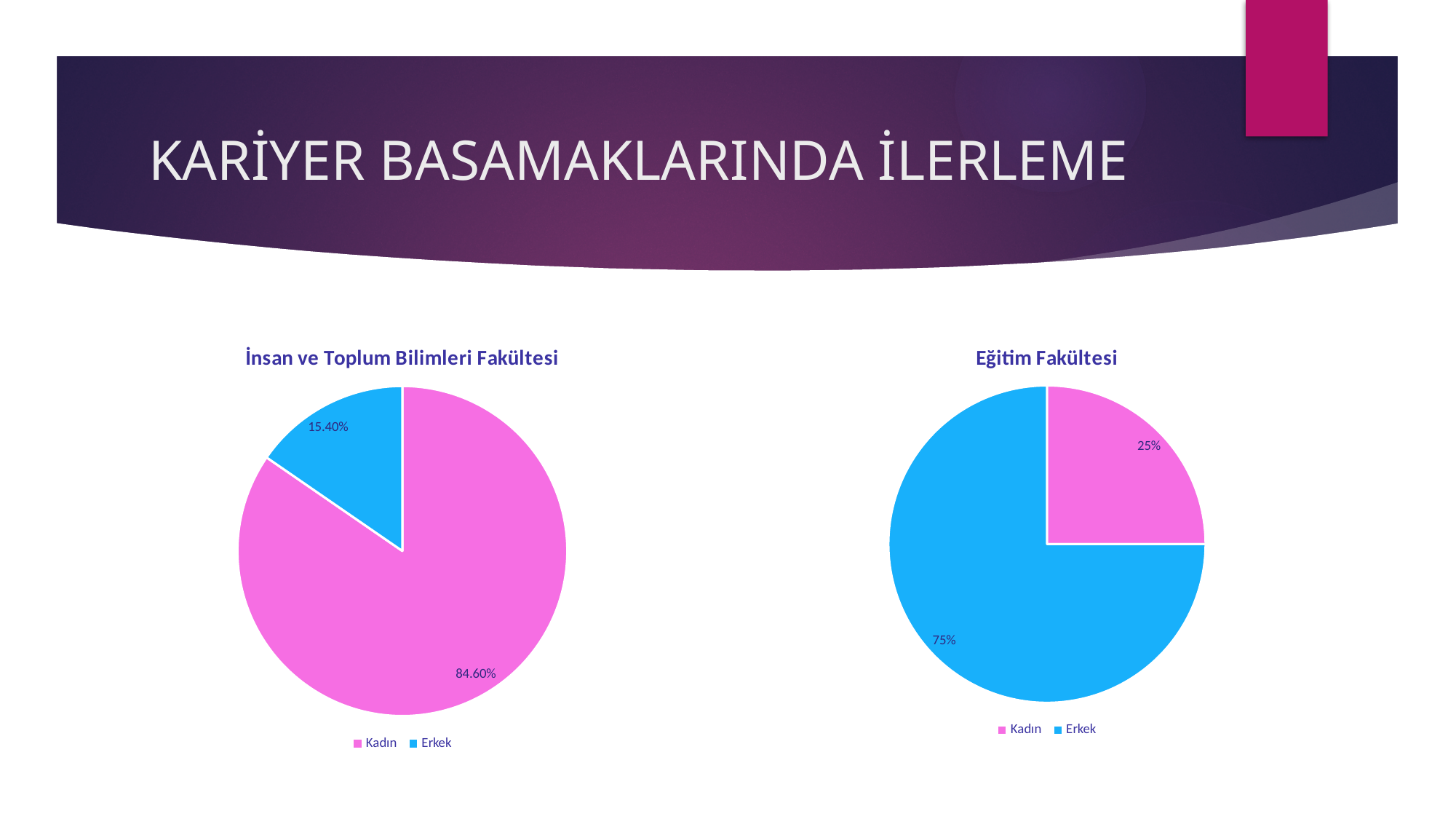
In the 'İnsan ve Toplum Bilimleri Fakültesi' chart, what colour is the Erkek slice? Blue In the 'İnsan ve Toplum Bilimleri Fakültesi' chart, what is the value for Kadın? 84.60% In the 'Eğitim Fakültesi' chart, what is the value for Kadın? 25% How many slices does the 'Eğitim Fakültesi' pie chart have? 2 In the 'Eğitim Fakültesi' chart, which is larger, Kadın or Erkek? Erkek In the 'İnsan ve Toplum Bilimleri Fakültesi' chart, what is the value for Erkek? 15.40% What type of chart is the 'İnsan ve Toplum Bilimleri Fakültesi' chart? Pie chart In the 'İnsan ve Toplum Bilimleri Fakültesi' chart, what is the difference between the Kadın and Erkek values? 69.20% In the 'Eğitim Fakültesi' chart, which category has the smallest slice? Kadın In the 'Eğitim Fakültesi' chart, what is the difference between the Erkek and Kadın values? 50% In the 'İnsan ve Toplum Bilimleri Fakültesi' chart, which category has the largest slice? Kadın In the 'Eğitim Fakültesi' chart, what is the value for Erkek? 75%